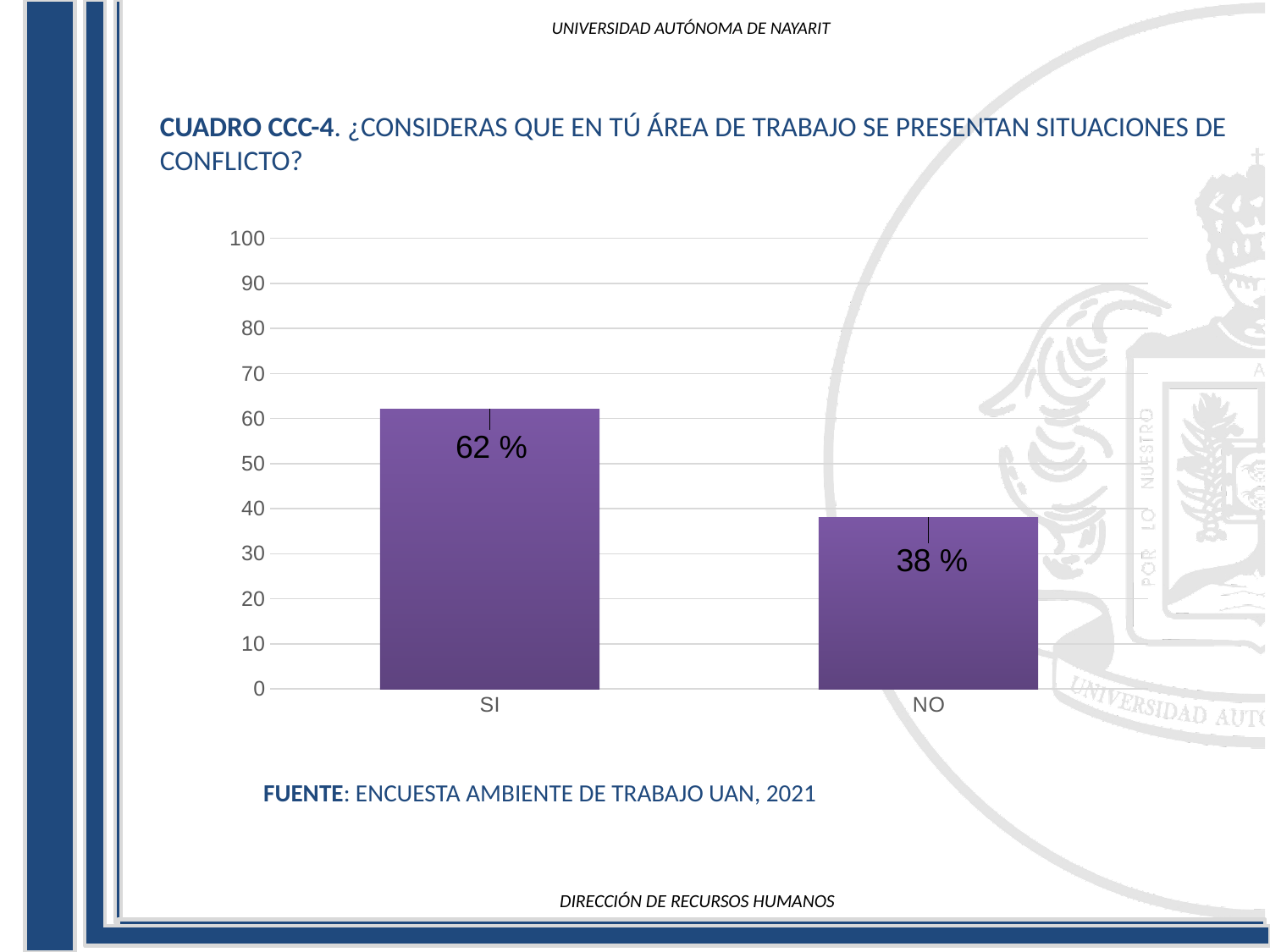
Which category has the highest value? SI Which category has the lowest value? NO How many categories are shown on the x axis? 2 Is the value for NO greater or less than 40? less What source is cited below the chart? ENCUESTA AMBIENTE DE TRABAJO UAN, 2021 What kind of chart is shown on the slide? bar chart Is the value for SI greater or less than 50? greater Which is larger, the value for SI or the value for NO? SI What is the value for SI? 62 % What is the value for NO? 38 % What is the maximum value shown on the y axis? 100 What is the difference between the values for SI and NO? 24 %